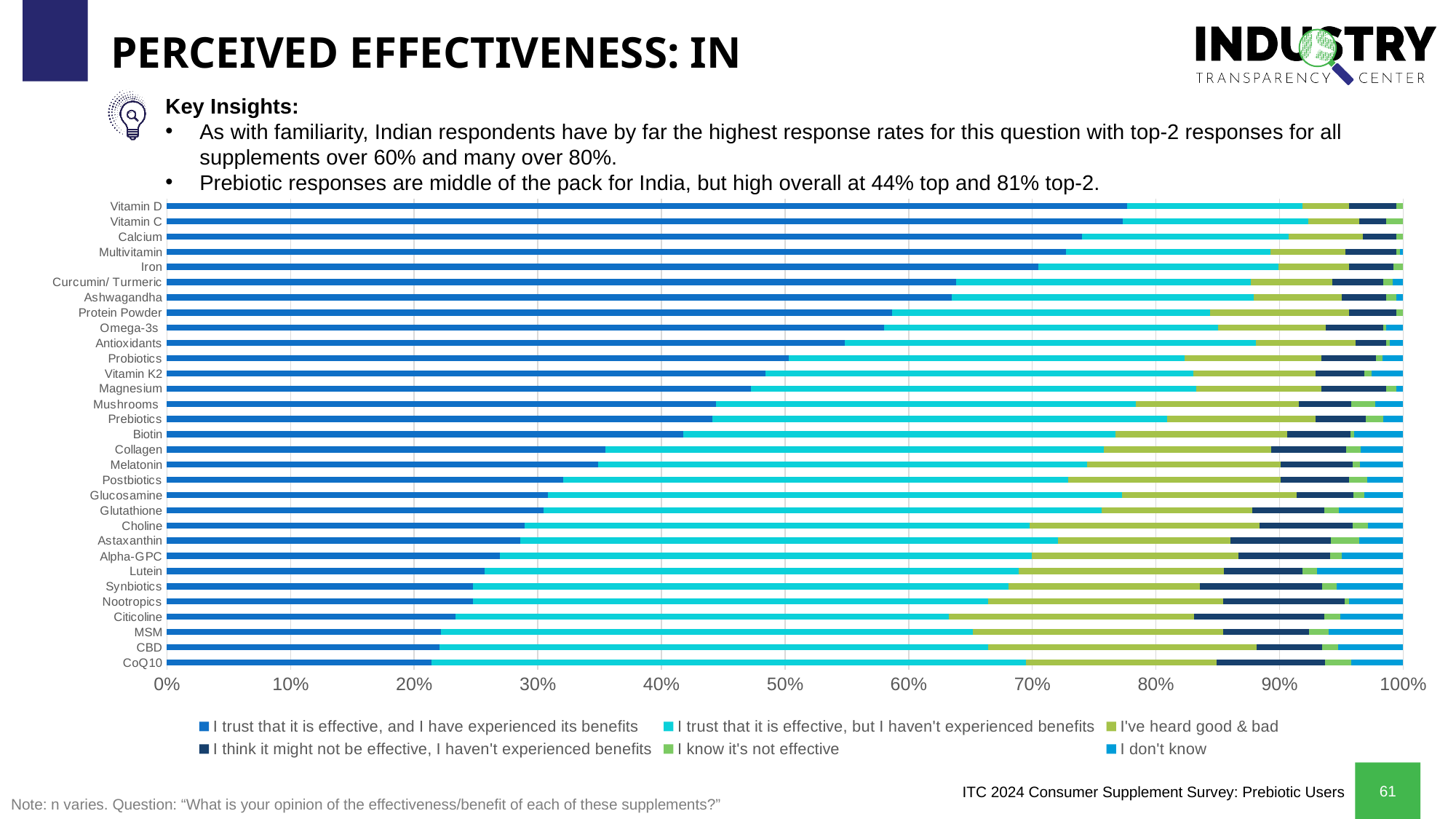
Which has a larger 'I trust that it is effective, and I have experienced its benefits' share, Probiotics or Prebiotics? Probiotics Is the 'I trust that it is effective, and I have experienced its benefits' share for CoQ10 greater or less than 30%? less Is the 'I trust that it is effective, and I have experienced its benefits' share for Melatonin greater or less than 40%? less Which supplement has the smallest share for 'I trust that it is effective, and I have experienced its benefits'? CoQ10 Moving down the chart from Vitamin D to CoQ10, does the 'I trust that it is effective, and I have experienced its benefits' share rise or fall? fall How many supplements are listed on the vertical axis of the chart? 31 What is the last entry in the chart legend? I don't know What kind of chart is shown on the slide? Stacked bar chart Which supplement has the largest share for 'I trust that it is effective, and I have experienced its benefits'? Vitamin D How many series does the legend list? 6 According to the key insights, what is the top response share for Prebiotics in India? 44% Is the 'I trust that it is effective, and I have experienced its benefits' share for Vitamin D greater or less than 70%? greater